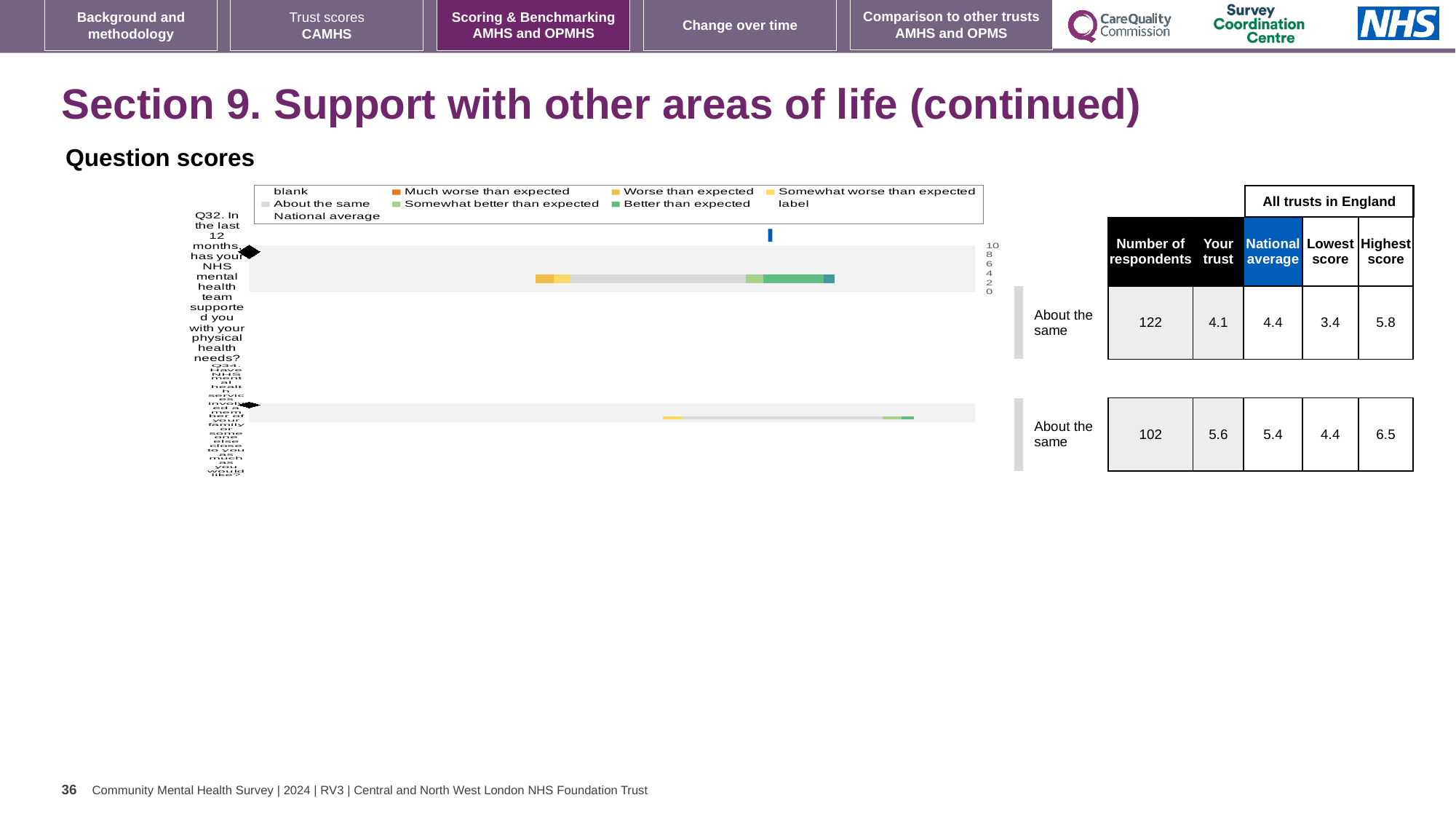
Which legend entry is shown in orange? Much worse than expected How many entries does the chart legend list? 9 In the table beside the chart, what is the national average for Q32? 4.4 How many question bars are plotted in the chart? 2 What kind of chart is shown under "Question scores"? bar chart Which legend entry is shown in grey? About the same In the table beside the chart, what is the number of respondents for Q32? 122 In the table beside the chart, which is larger for Q32: the "Your trust" score or the national average? National average In the table beside the chart, what is the difference between the highest score and the lowest score for Q32? 2.4 In the table beside the chart, what is the highest score for Q34? 6.5 In the table beside the chart, which question has the higher "Your trust" score, Q32 or Q34? Q34 In the table beside the chart, what is the "Your trust" score for Q34? 5.6